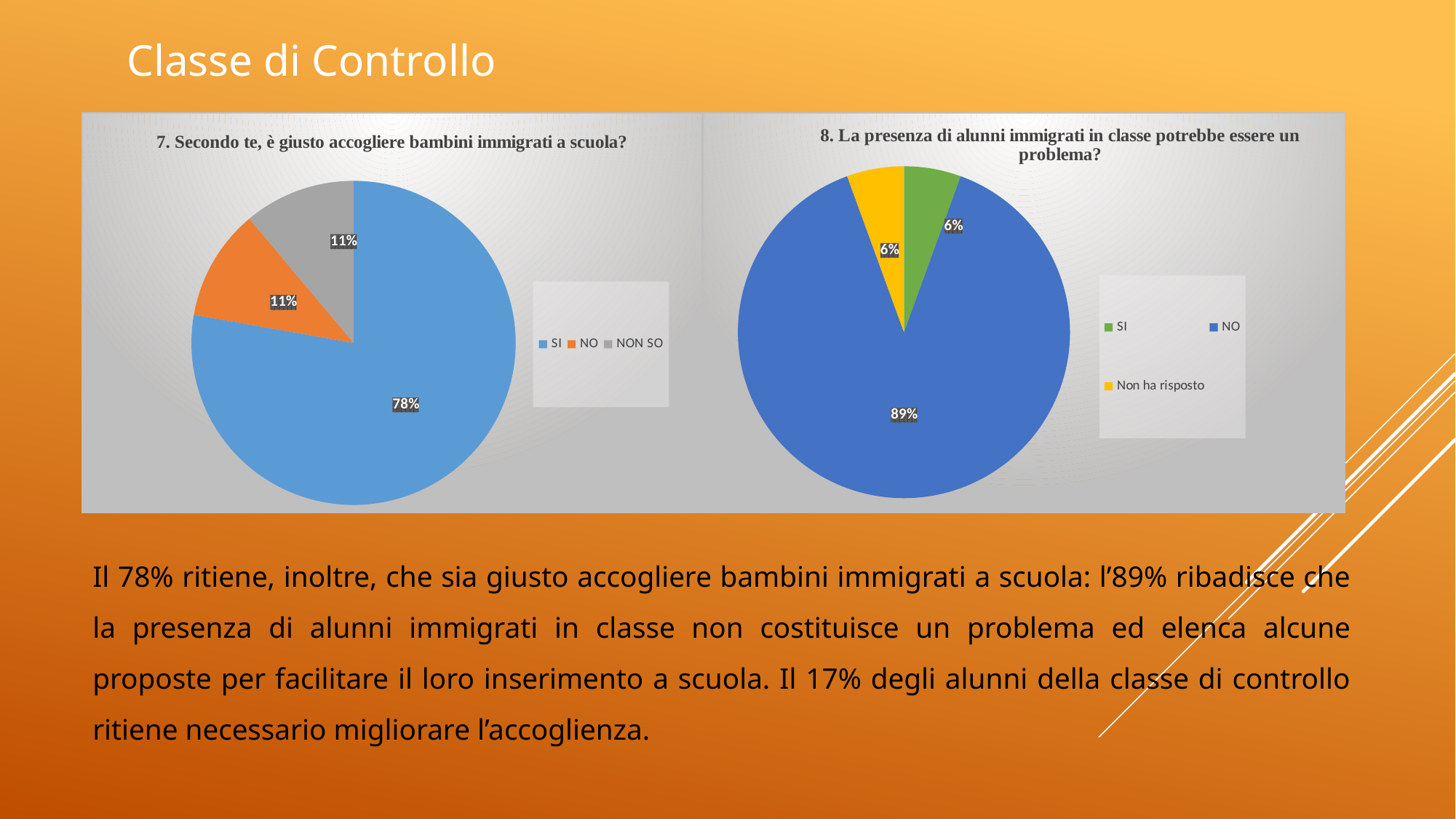
In the left chart (question 7), which answer has the largest slice? SI What type of chart is used for question 7 on the left? Pie chart In the left chart (question 7), what share of respondents answered NON SO? 11% In the right chart (question 8), what share of respondents is labelled 'Non ha risposto'? 6% How many entries does the legend of the right chart (question 8) list? 3 In the right chart (question 8), which answer has the smallest slice, SI or NO? SI In the right chart (question 8), what colour is the NO slice? Blue In the right chart (question 8), what share of respondents answered NO? 89% How many slices does the left pie chart (question 7) have? 3 In the right chart (question 8), what is the difference between the NO share and the SI share? 83 percentage points In the left chart (question 7), what share of respondents answered SI? 78% In the left chart (question 7), what is the difference between the SI share and the NO share? 67 percentage points